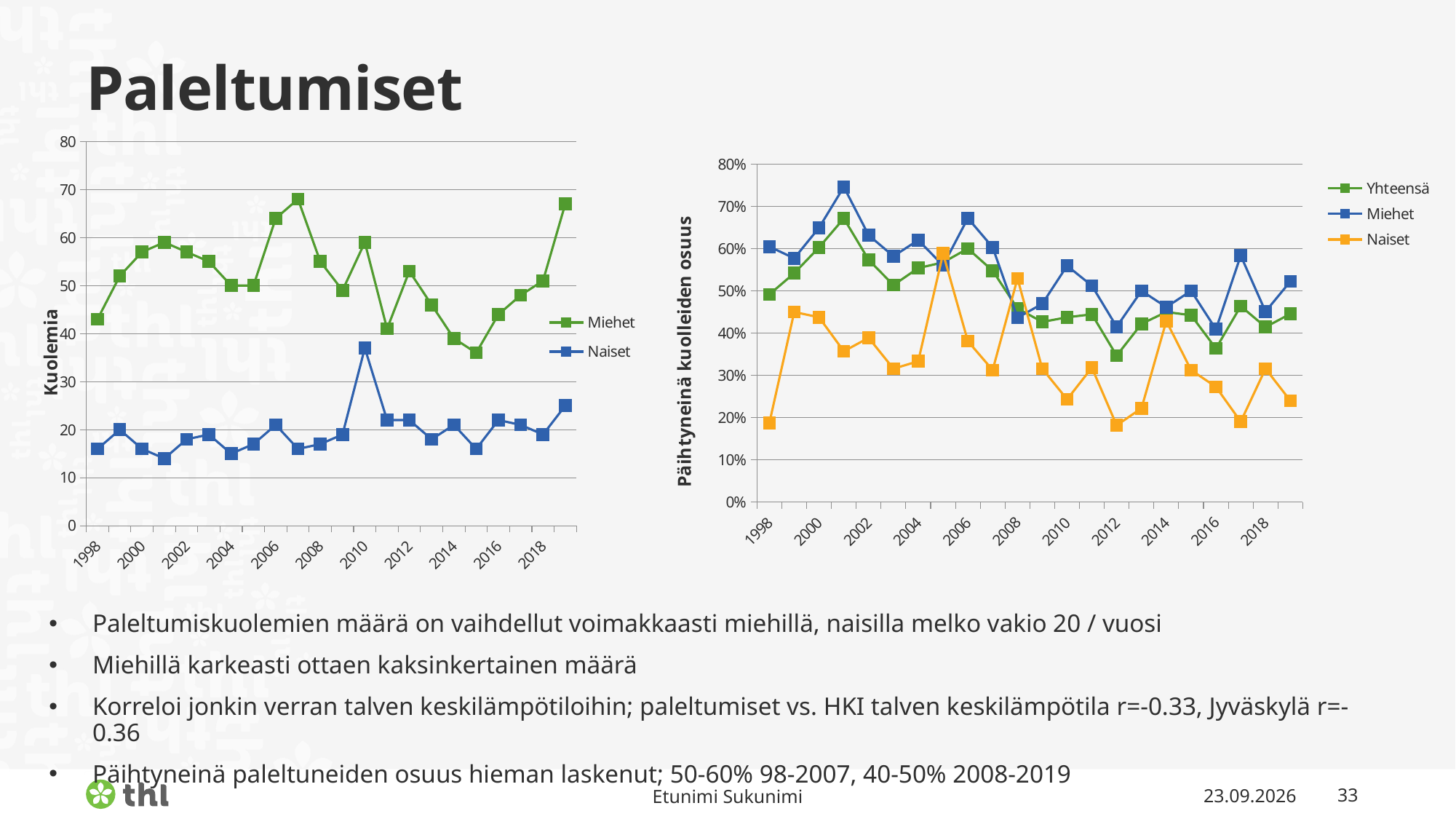
How many series does the legend of the left chart (Kuolemia) list? 2 How many series does the legend of the right chart (Päihtyneinä kuolleiden osuus) list? 3 In the right chart (Päihtyneinä kuolleiden osuus), is the Miehet value for 2001 greater or less than 70%? greater How many data points does the Miehet series have in the left chart (Kuolemia)? 22 In the right chart (Päihtyneinä kuolleiden osuus), in which year does the Miehet series reach its highest value? 2001 In the left chart (Kuolemia), in which year does the Miehet series reach its lowest value? 2015 In the left chart (Kuolemia), is the Miehet value for 2015 greater or less than 40? less In the right chart (Päihtyneinä kuolleiden osuus), which series has the larger value in 2008, Miehet or Naiset? Naiset What kind of chart is the left chart (Kuolemia)? line chart In the left chart (Kuolemia), in which year does the Miehet series reach its highest value? 2007 In the left chart (Kuolemia), is the Naiset value for 2010 greater or less than 30? greater In the left chart (Kuolemia), in which year does the Naiset series reach its highest value? 2010